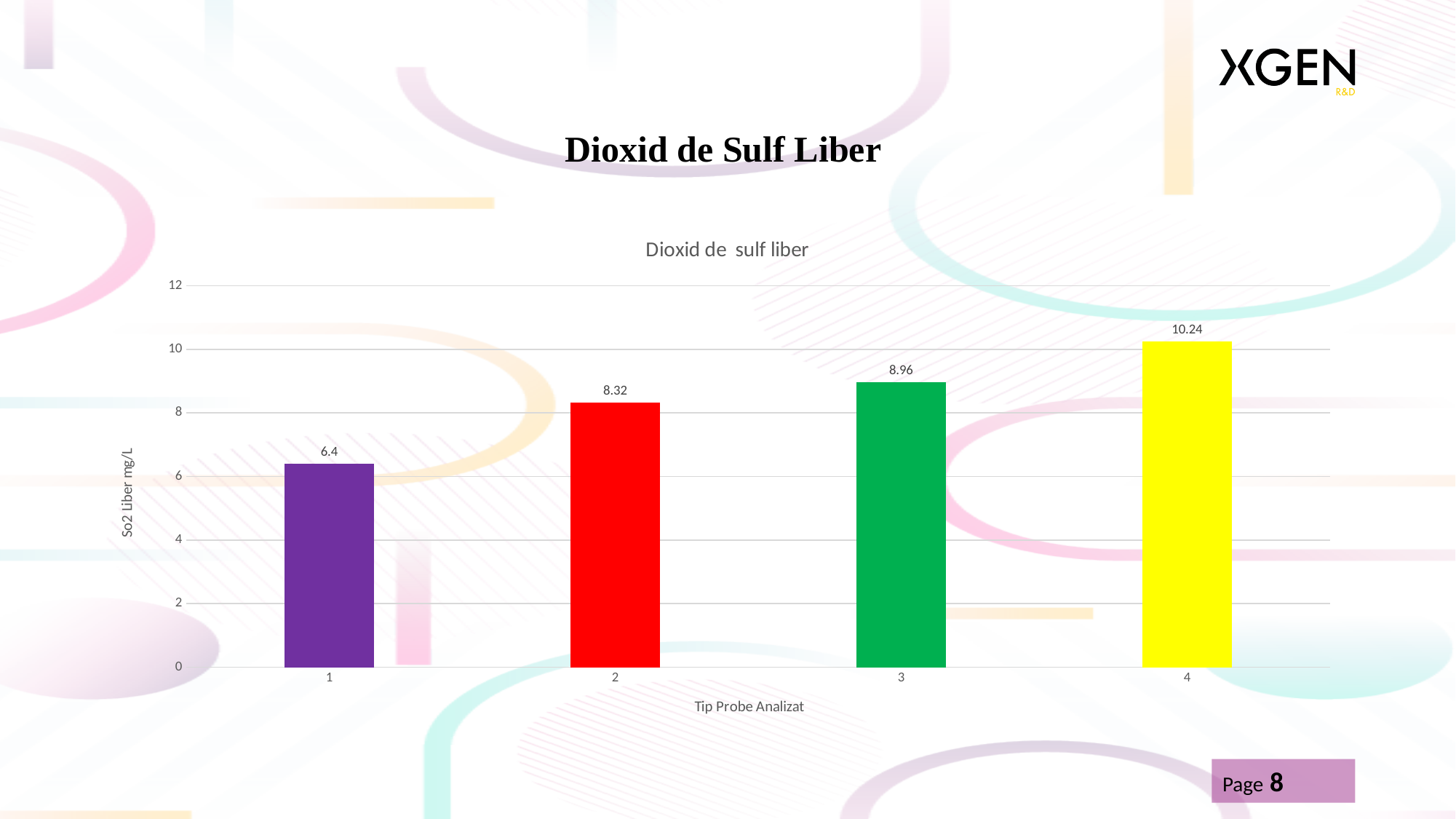
What is the value for category 3? 8.96 Which is larger, the value for category 2 or the value for category 3? 3 Which category has the highest value? 4 What kind of chart is shown? bar chart What is the difference between the values for category 3 and category 2? 0.64 Do the values rise or fall from category 1 to category 4? rise Which category has the lowest value? 1 What is the difference between the values for category 4 and category 1? 3.84 Is the value for category 4 greater or less than 10? greater What is the value for category 4? 10.24 How many categories are shown on the x axis? 4 What is the value for category 1? 6.4